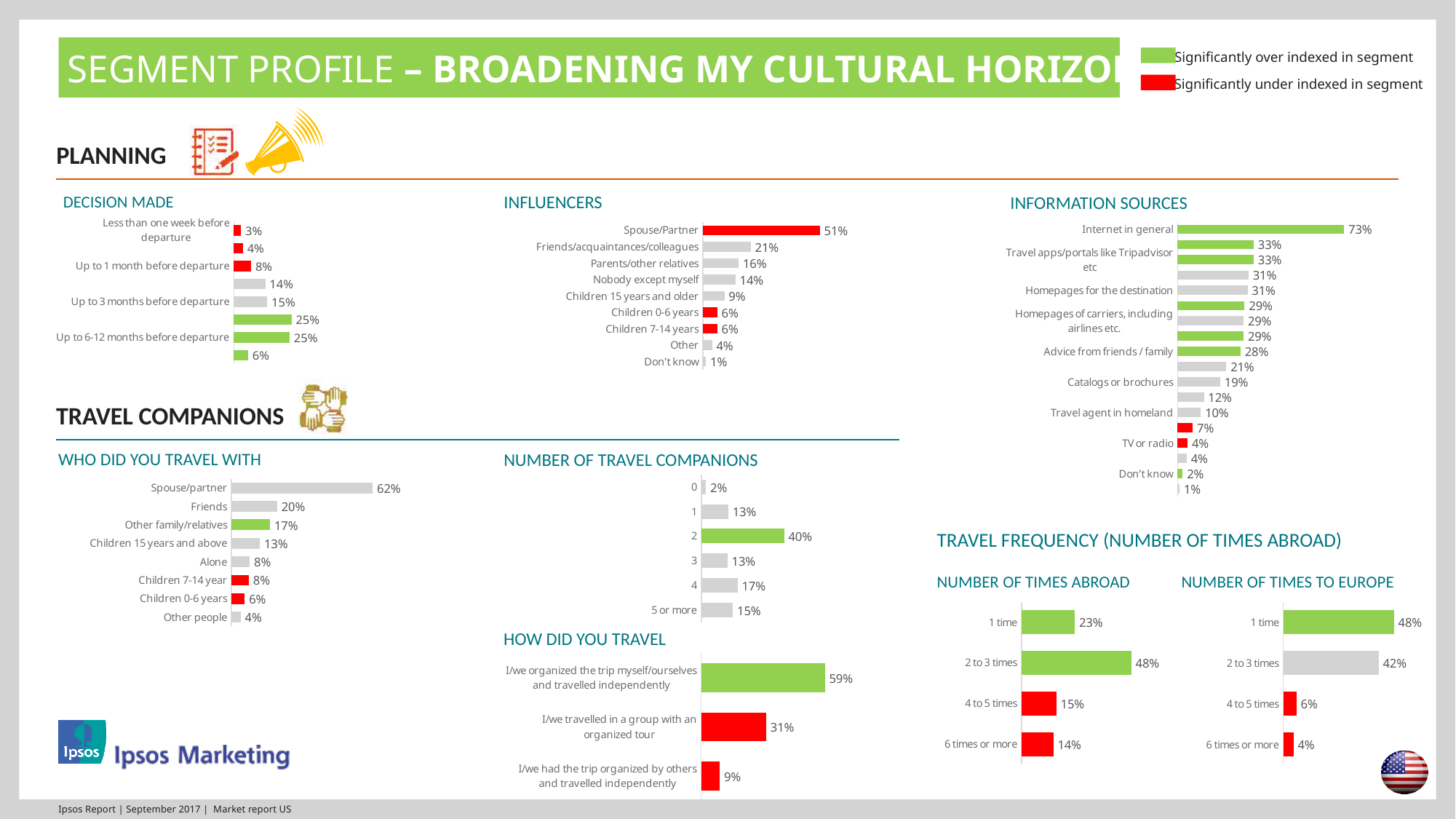
In the INFORMATION SOURCES chart, what is the value for Advice from friends / family? 28% In the DECISION MADE chart, what is the value for Up to 6-12 months before departure? 25% In the INFORMATION SOURCES chart, which category has the highest value? Internet in general In the NUMBER OF TRAVEL COMPANIONS chart, how many categories are shown? 6 In the HOW DID YOU TRAVEL chart, what is the value for 'I/we travelled in a group with an organized tour'? 31% In the NUMBER OF TIMES TO EUROPE chart, what is the value for 6 times or more? 4% In the WHO DID YOU TRAVEL WITH chart, what is the difference between Spouse/partner and Friends? 42% In the INFLUENCERS chart, what is the value for Spouse/Partner? 51% What kind of chart is the INFLUENCERS chart? Bar chart In the NUMBER OF TIMES ABROAD chart, which is larger: 1 time or 2 to 3 times? 2 to 3 times In the NUMBER OF TIMES TO EUROPE chart, which category has the lowest value? 6 times or more In the NUMBER OF TRAVEL COMPANIONS chart, which category has the highest value? 2